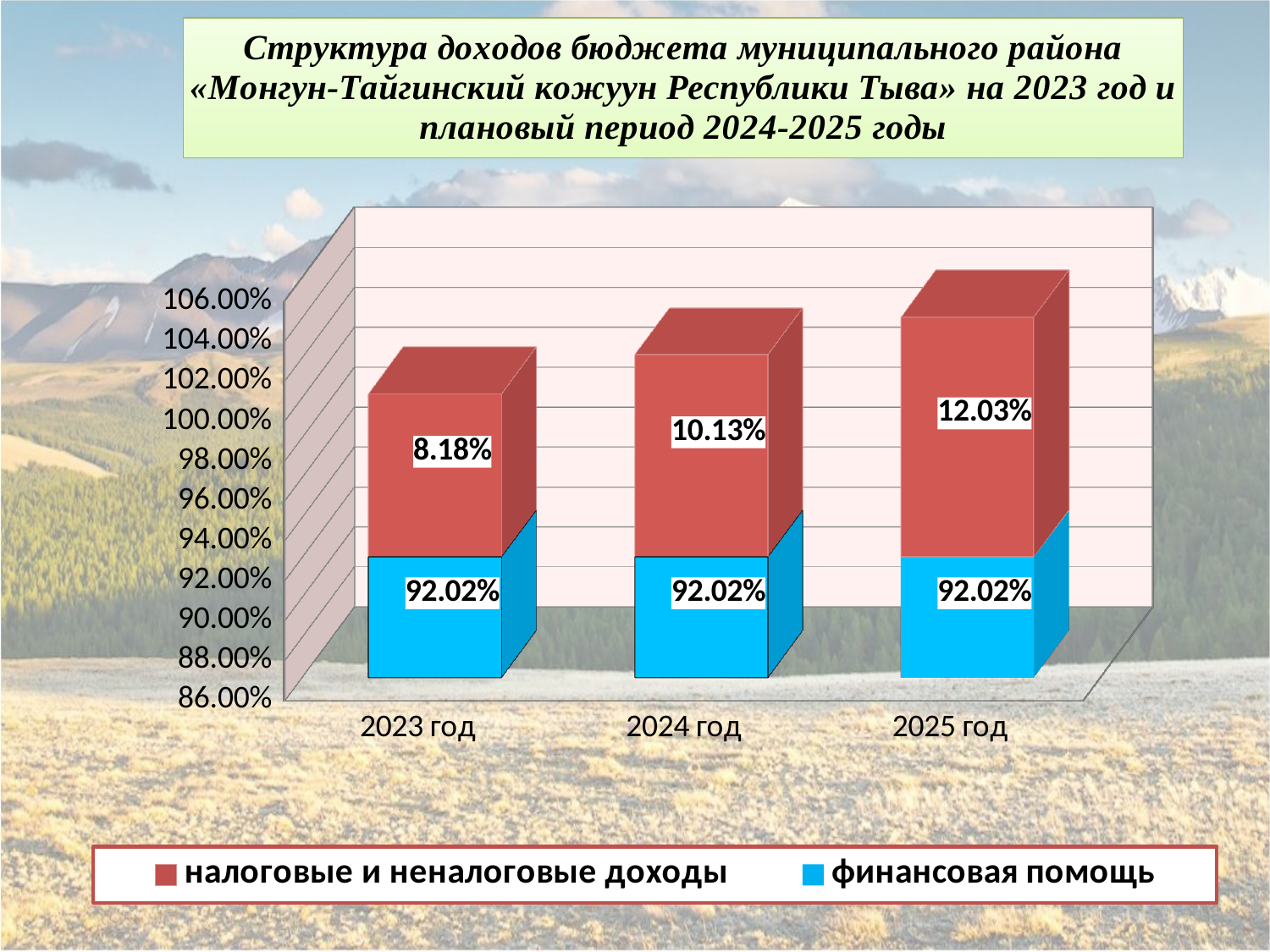
What is the value of 'финансовая помощь' for 2025 год? 92.02% In which year is the value of 'налоговые и неналоговые доходы' the highest? 2025 год What is the value of 'налоговые и неналоговые доходы' for 2023 год? 8.18% How many series does the legend list? 2 How many years (categories) are shown on the x axis? 3 What type of chart is shown on the slide? bar chart Do the values of 'налоговые и неналоговые доходы' rise or fall from 2023 год to 2025 год? rise What is the total of the stacked bar for 2024 год? 102.15% In which year is the value of 'налоговые и неналоговые доходы' the lowest? 2023 год What is the value of 'налоговые и неналоговые доходы' for 2024 год? 10.13% What is the difference between the 'налоговые и неналоговые доходы' values for 2025 год and 2023 год? 3.85% What is the value of 'налоговые и неналоговые доходы' for 2025 год? 12.03%